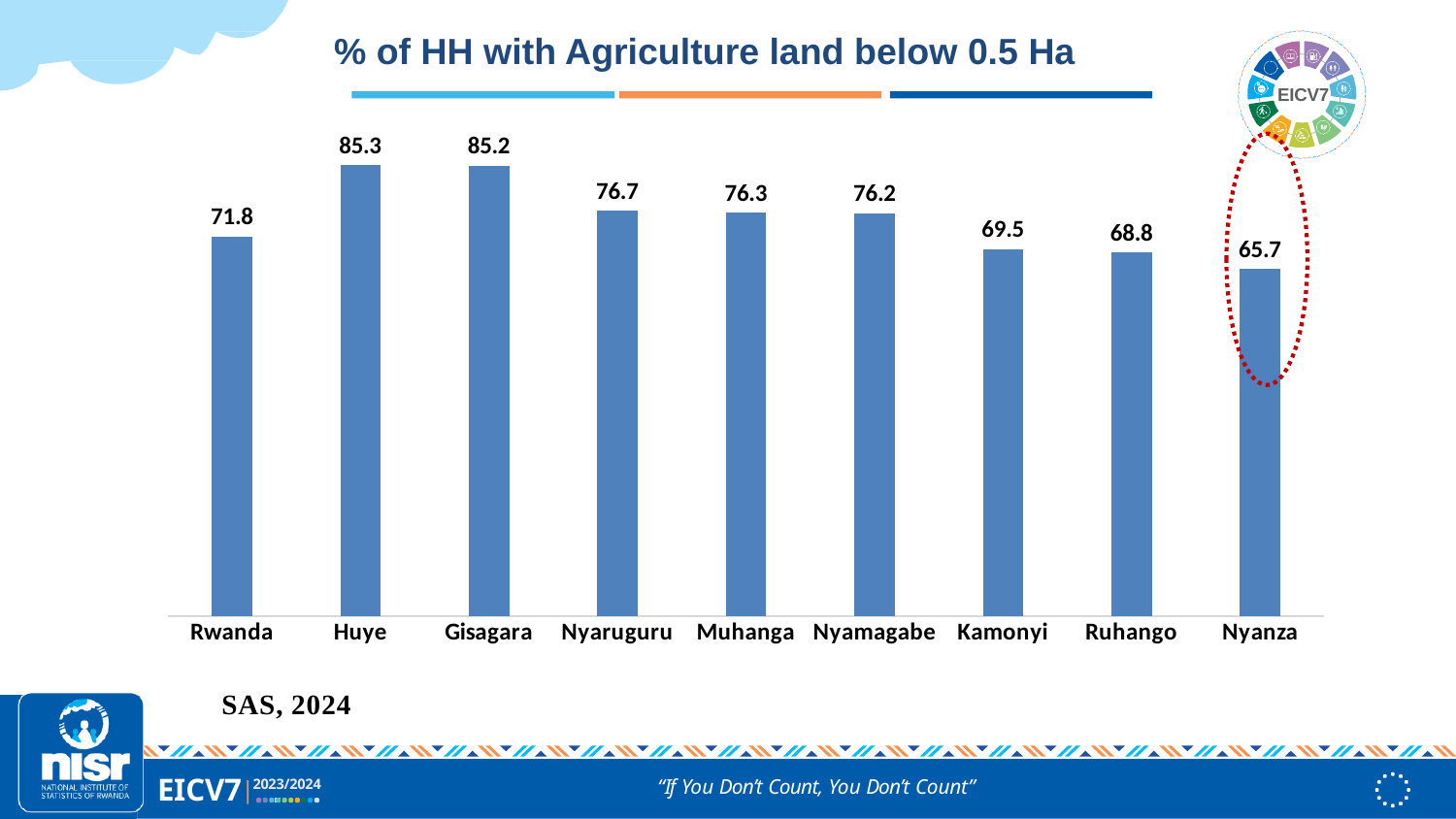
What is the difference between the values for Rwanda and Nyanza? 6.1 What is the value for Ruhango? 68.8 Which district has the lowest percentage of households with agriculture land below 0.5 Ha? Nyanza What is the difference between the values for Huye and Nyanza? 19.6 What is the value for Nyamagabe? 76.2 Which is larger, the value for Nyaruguru or the value for Kamonyi? Nyaruguru What is the title of the chart? % of HH with Agriculture land below 0.5 Ha What is the value for Nyanza? 65.7 How many categories are shown on the x axis? 9 What kind of chart is shown on the slide? Bar chart Which category has the highest value in the chart? Huye What is the value for Rwanda? 71.8